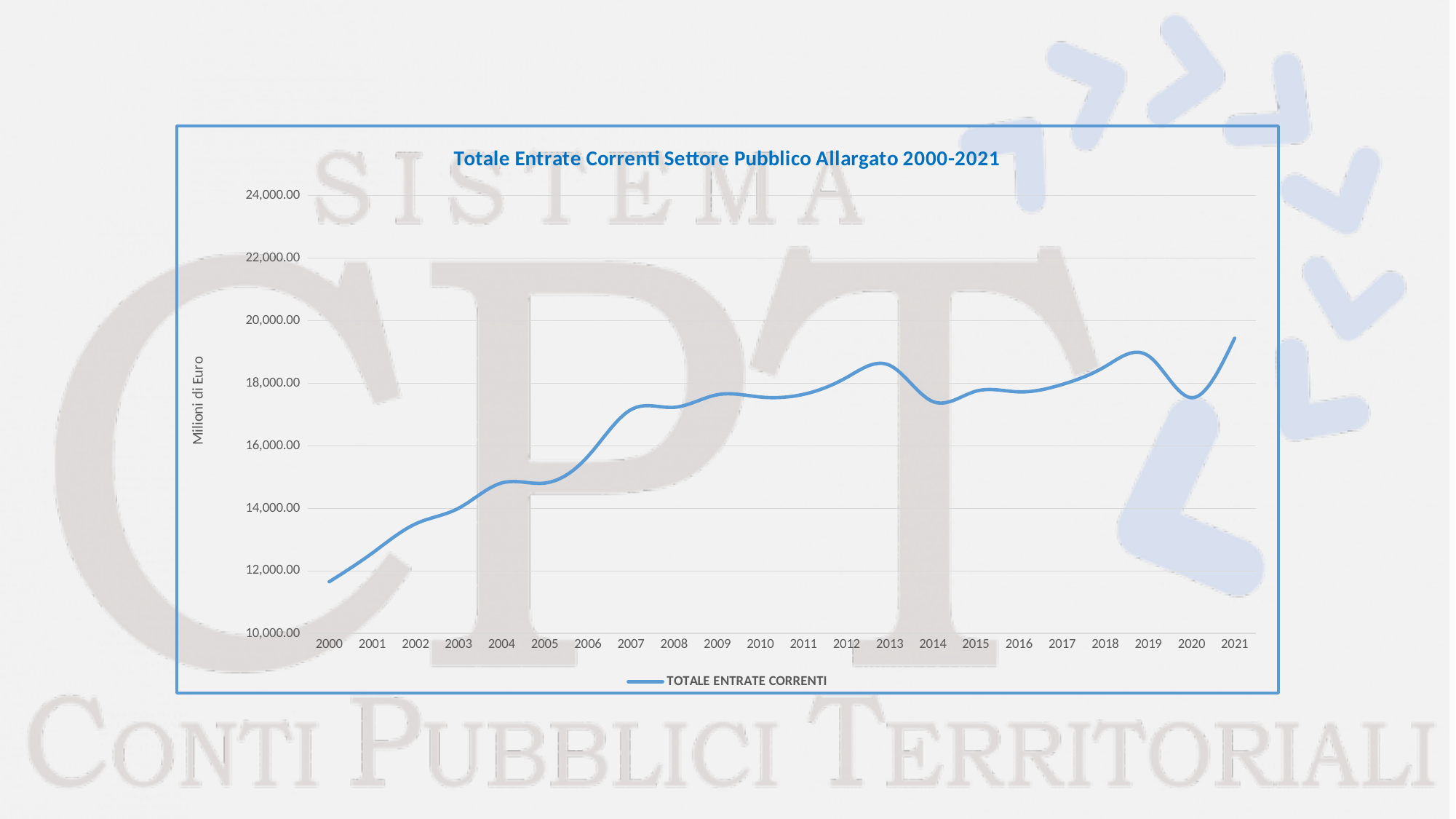
What is the title of the chart? Totale Entrate Correnti Settore Pubblico Allargato 2000-2021 Is the value for 2000 greater or less than 12,000.00? less Overall, do the values rise or fall from 2000 to 2021? rise Is the value for 2020 greater or less than 18,000.00? less Is the value for 2010 greater or less than 16,000.00? greater How many series does the legend list? 1 Which year has the highest value for TOTALE ENTRATE CORRENTI? 2021 What kind of chart is shown on the slide? line chart Which year has the larger value, 2019 or 2020? 2019 Which year has the lowest value for TOTALE ENTRATE CORRENTI? 2000 How many years are plotted along the x axis? 22 What is the label of the vertical axis? Milioni di Euro